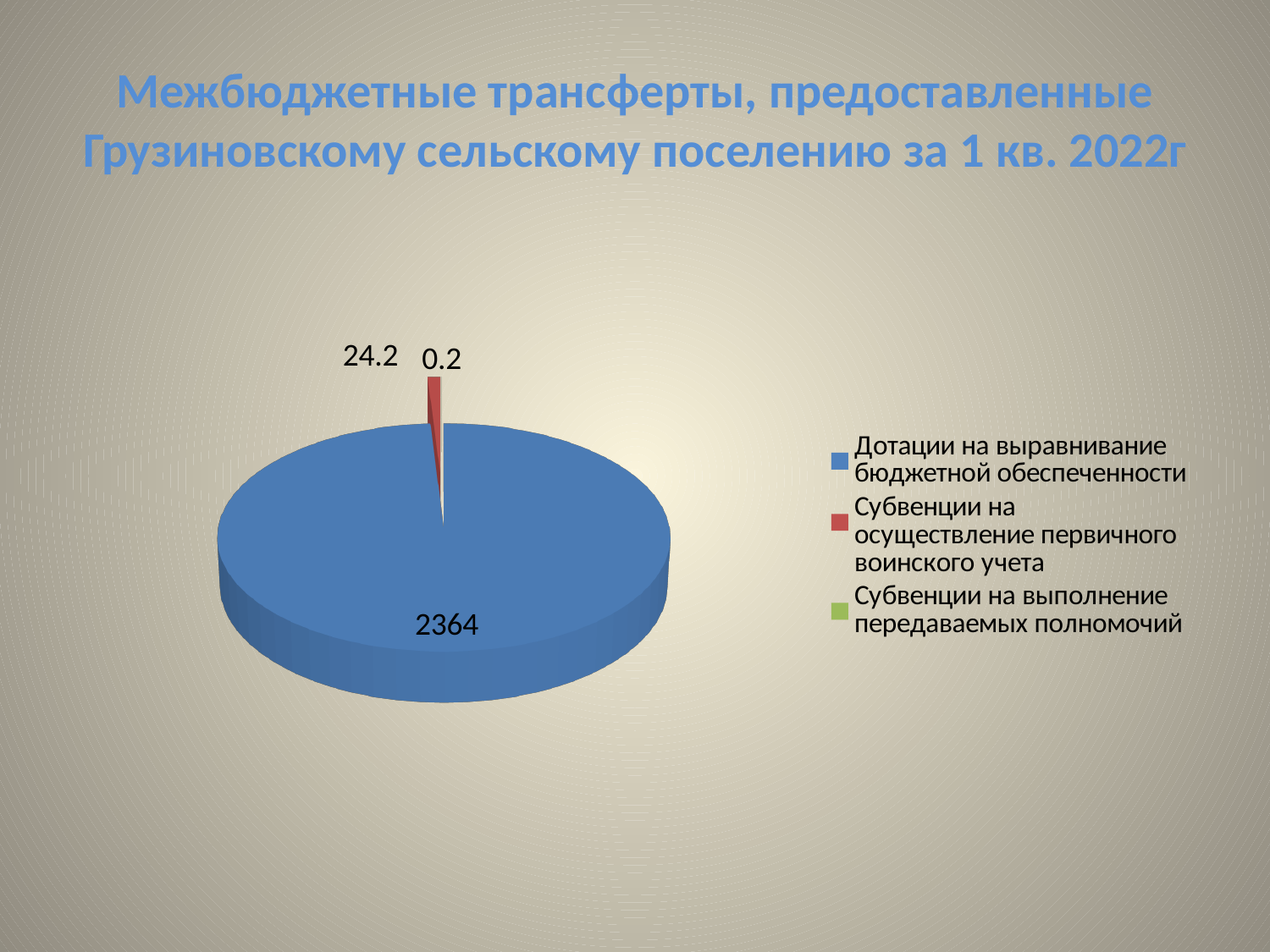
Which is larger: Субвенции на осуществление первичного воинского учета or Субвенции на выполнение передаваемых полномочий? Субвенции на осуществление первичного воинского учета What is the value for Субвенции на выполнение передаваемых полномочий? 0.2 How many categories does the legend list? 3 What is the value for Дотации на выравнивание бюджетной обеспеченности? 2364 Which category has the largest slice of the pie? Дотации на выравнивание бюджетной обеспеченности What is the difference between the value for Дотации на выравнивание бюджетной обеспеченности and the value for Субвенции на осуществление первичного воинского учета? 2339.8 Which category has the smallest value? Субвенции на выполнение передаваемых полномочий What is the difference between the value for Субвенции на осуществление первичного воинского учета and the value for Субвенции на выполнение передаваемых полномочий? 24 What colour represents Субвенции на осуществление первичного воинского учета in the legend? Red What is the value for Субвенции на осуществление первичного воинского учета? 24.2 What is the title of the chart slide? Межбюджетные трансферты, предоставленные Грузиновскому сельскому поселению за 1 кв. 2022г What type of chart is shown on the slide? Pie chart